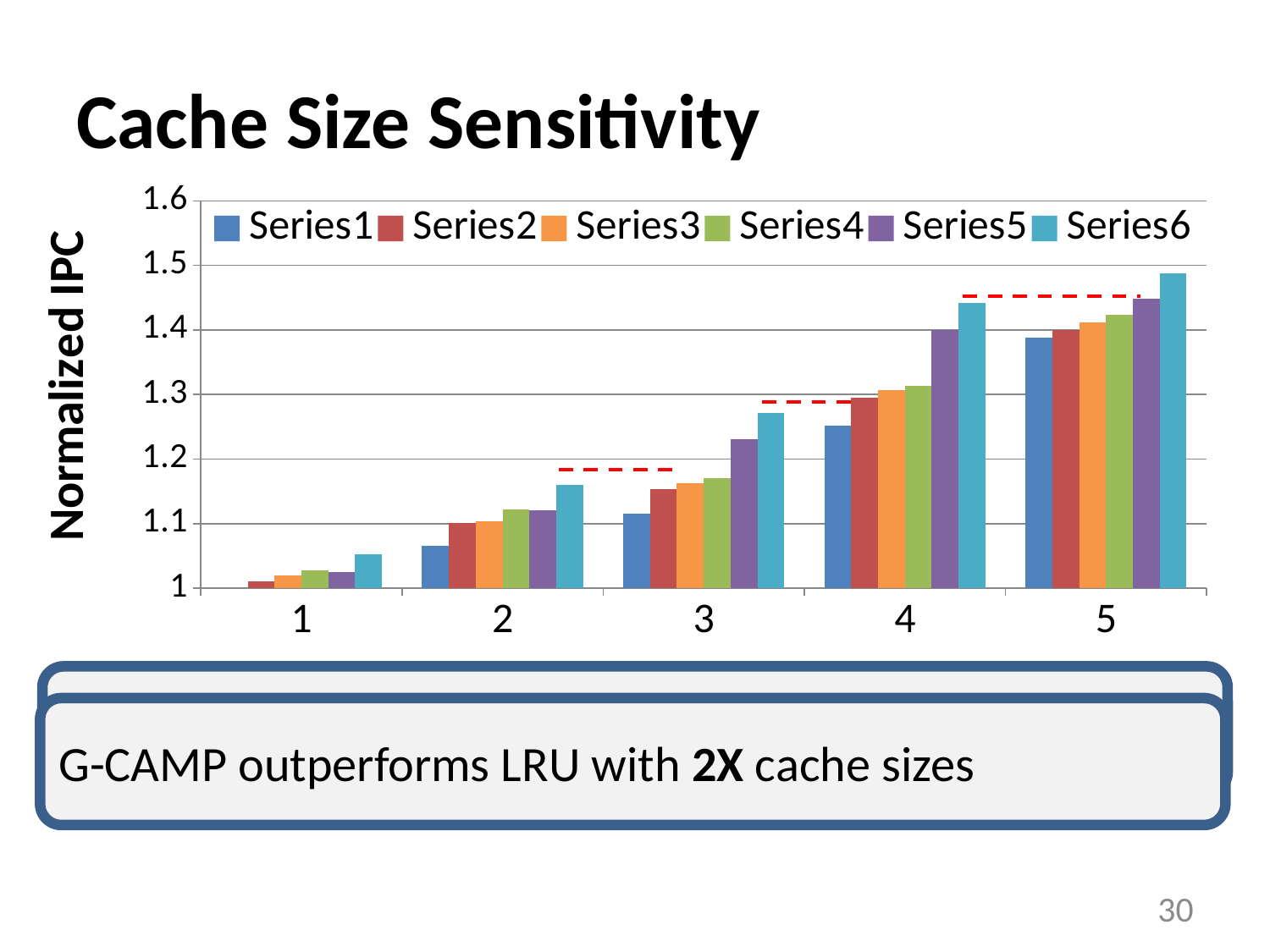
Which series is shown in the first (leftmost) legend entry? Series1 How many categories are shown on the x axis? 5 Is the value for Series1 at category 4 greater or less than 1.3? less Is the value for Series6 at category 3 greater or less than 1.2? greater What is the title of the y axis? Normalized IPC How many series does the legend list? 6 Is the value for Series6 at category 5 greater or less than 1.4? greater At category 4, which is larger: the value for Series5 or the value for Series1? Series5 What kind of chart is shown on the slide? bar chart Which series has the lowest value at category 5? Series1 Which series has the highest value at category 4? Series6 Do the values for Series6 rise or fall from category 1 to category 5? rise